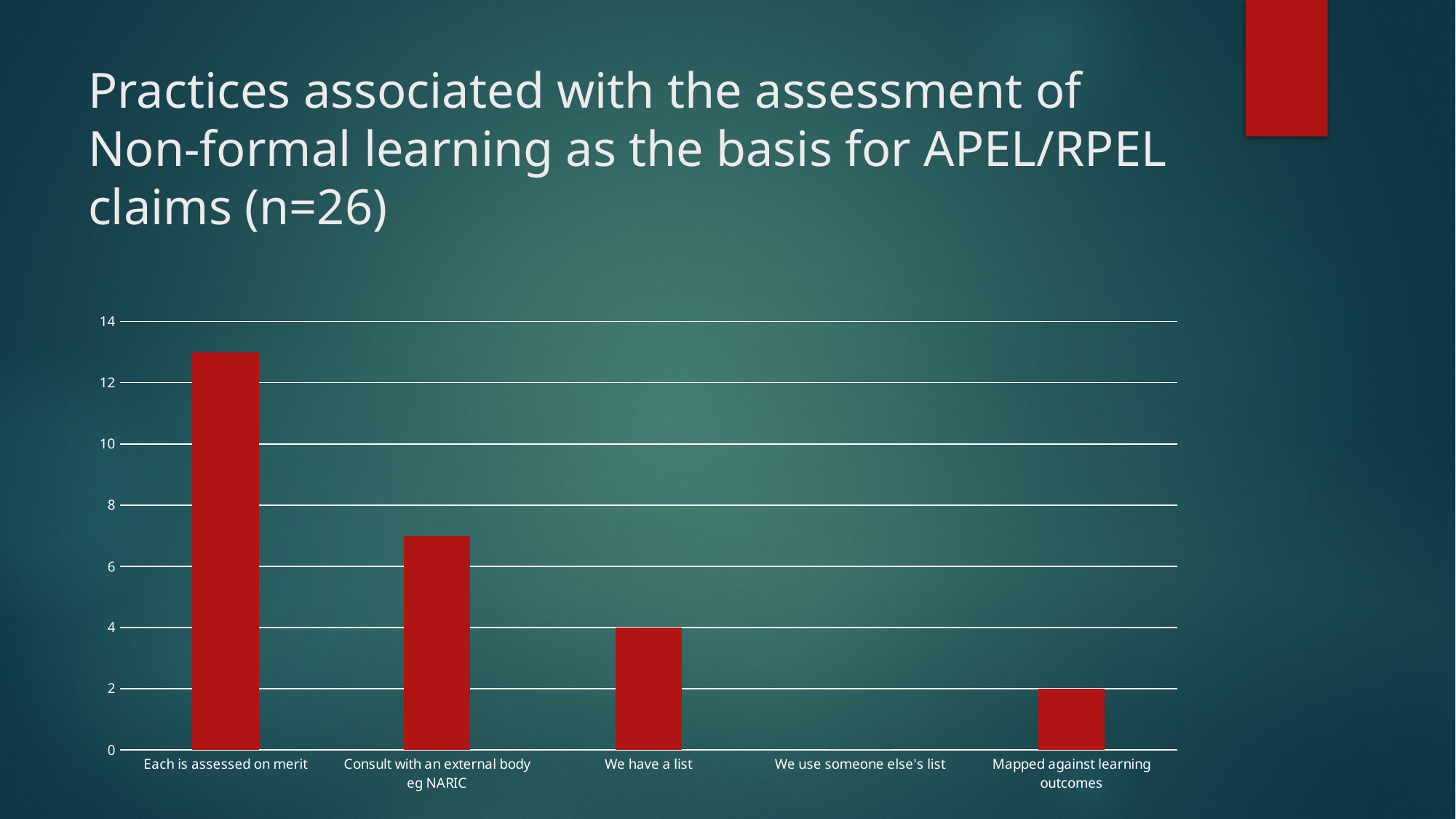
What is the value for 'We use someone else's list'? 0 Which is larger: the value for 'Consult with an external body eg NARIC' or the value for 'We have a list'? Consult with an external body eg NARIC What is the value for 'Mapped against learning outcomes'? 2 What kind of chart is shown on the slide? bar chart What is the value for 'We have a list'? 4 Which category has the highest value? Each is assessed on merit What is the sample size stated in the chart title? n=26 Is the value for 'Consult with an external body eg NARIC' greater or less than 8? less How many categories are shown on the x axis of the chart? 5 Which category has the lowest value? We use someone else's list Is the value for 'Each is assessed on merit' greater or less than 12? greater What is the difference between the values for 'We have a list' and 'Mapped against learning outcomes'? 2